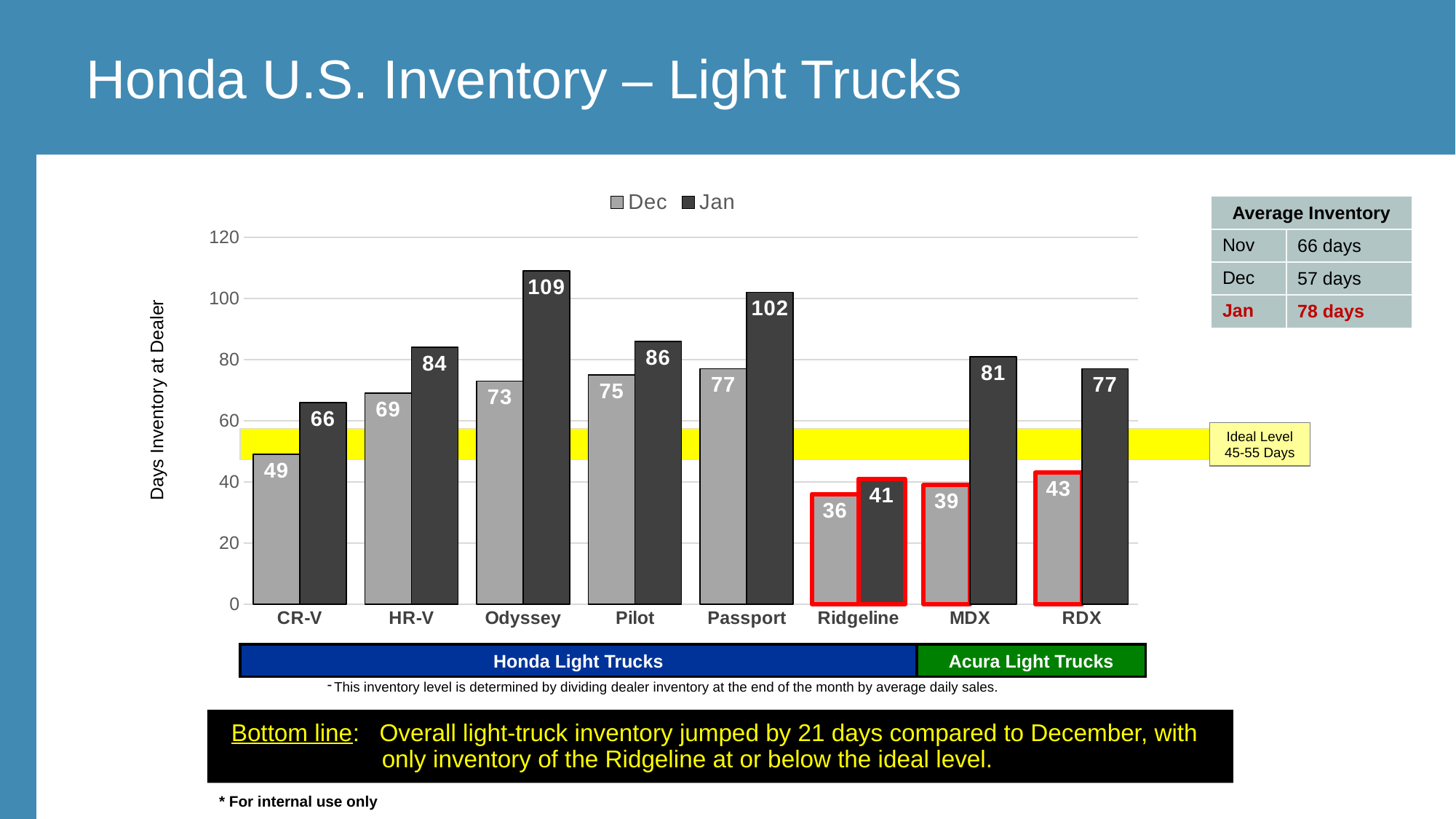
How many models are shown on the x axis? 8 What kind of chart is shown? bar chart What is the Dec value for Ridgeline? 36 How many series does the legend list? 2 What is the Jan value for MDX? 81 What is the Jan value for Odyssey? 109 What is the y-axis label of the chart? Days Inventory at Dealer Which is larger, the Jan value for Pilot or the Jan value for HR-V? Pilot Which model has the highest Jan value? Odyssey What is the difference between the Jan and Dec values for MDX? 42 Which model has the lowest Dec value? Ridgeline Is the Dec value for Passport greater or less than 60? greater